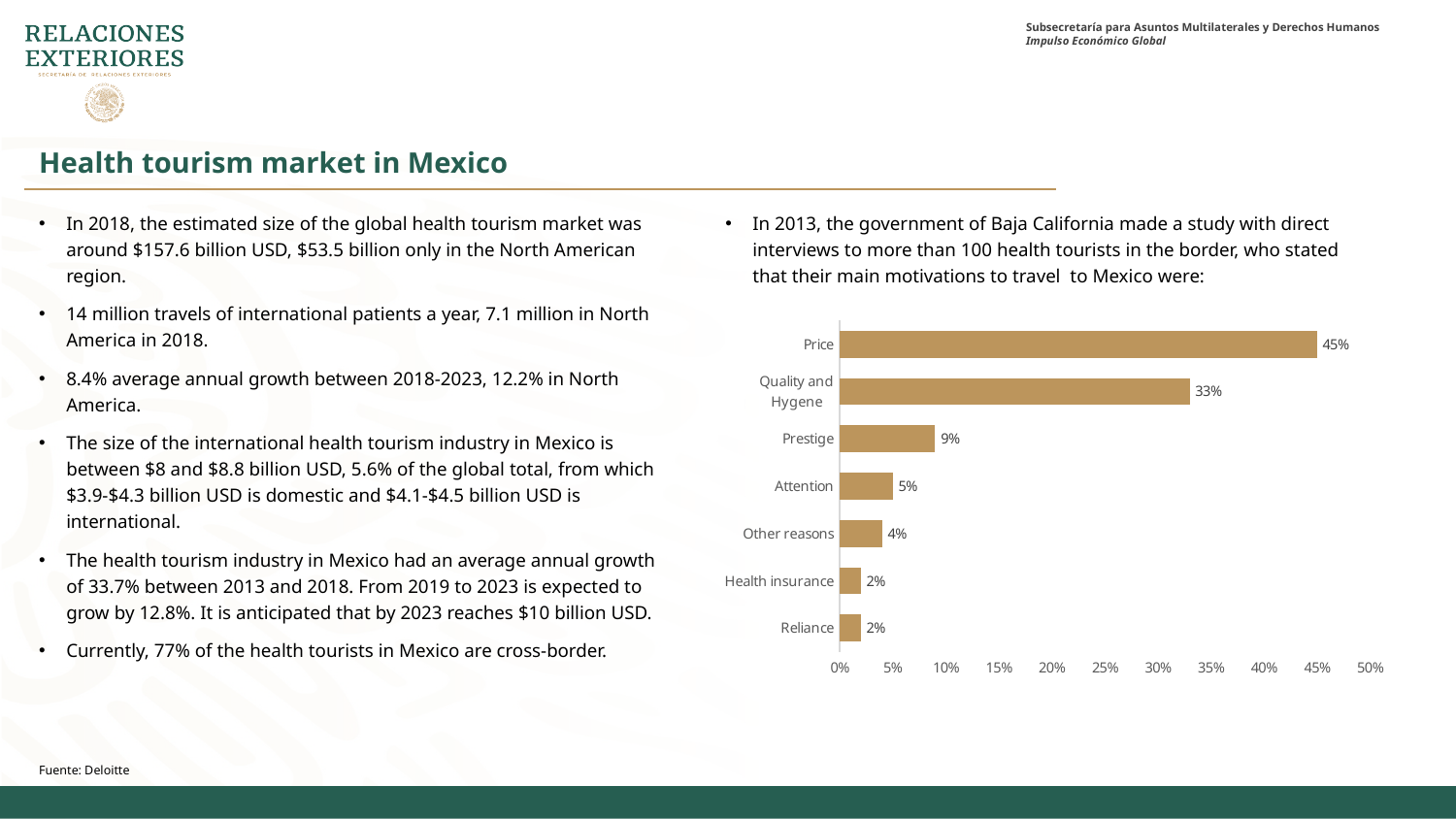
What is the highest value shown on the chart's horizontal axis? 50% Is the value for Quality and Hygene greater or less than 30%? greater What is the value for Prestige? 9% What kind of chart is shown on the slide? Bar chart What is the value for Price? 45% What is the difference between the values for Price and Quality and Hygene? 12% What is the value for Quality and Hygene? 33% What is the value for Other reasons? 4% Which is larger, the value for Prestige or the value for Attention? Prestige How many categories are shown in the chart? 7 Which category has the highest value? Price What is the value for Attention? 5%